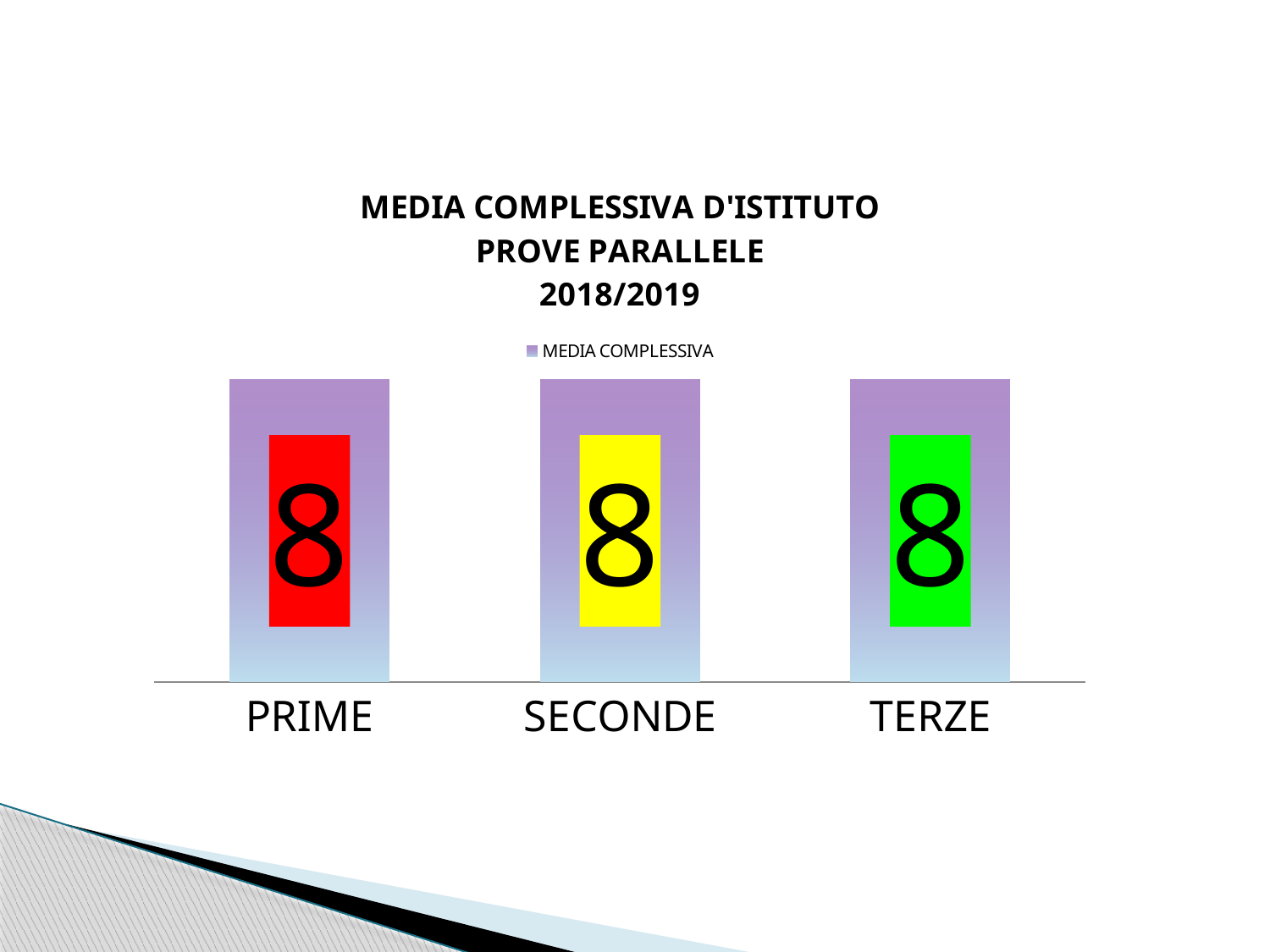
What is the value for PRIME? 8 Do the values rise, fall or stay the same from PRIME to TERZE? stay the same How many categories are shown on the x axis? 3 What is the difference between the values for SECONDE and PRIME? 0 How many series does the legend list? 1 What is the value for TERZE? 8 What is the difference between the values for PRIME and TERZE? 0 What is the name of the series listed in the legend? MEDIA COMPLESSIVA What is the value for SECONDE? 8 Which school year is given in the chart title? 2018/2019 What kind of chart is shown on the slide? bar chart